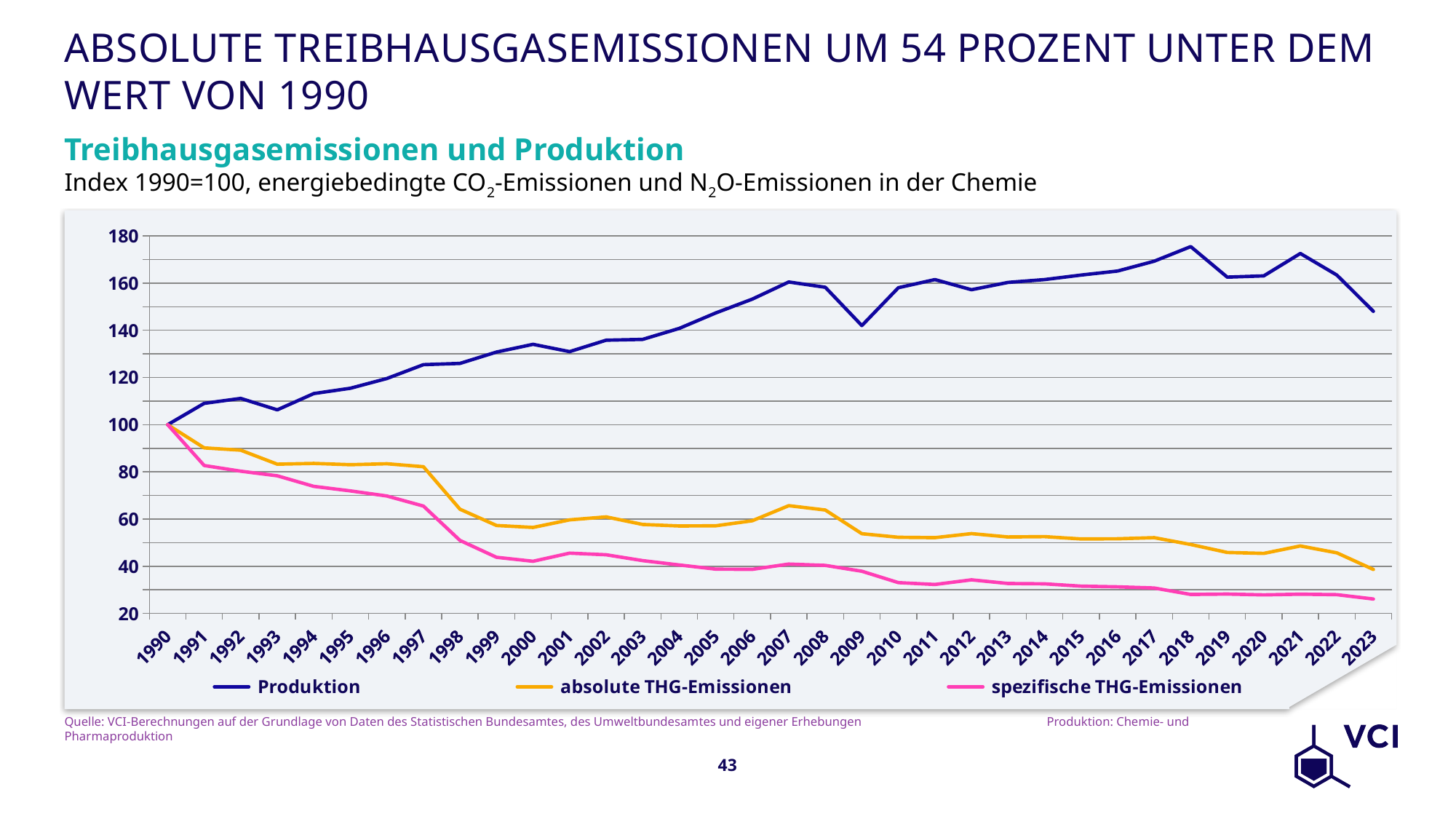
Is the value for absolute THG-Emissionen in 2007 greater or less than 60? greater Which series is drawn in orange? absolute THG-Emissionen How many years are plotted along the x axis? 34 Is the value for spezifische THG-Emissionen in 2023 greater or less than 40? less What is the index value of Produktion in 1990? 100 Is the value for Produktion in 2018 greater or less than 160? greater Does the spezifische THG-Emissionen line generally rise or fall from 1990 to 2023? fall In 2023, which is larger: Produktion or absolute THG-Emissionen? Produktion What kind of chart is shown on the slide? line chart How many series does the legend list? 3 In which year is the spezifische THG-Emissionen line at its lowest? 2023 In which year does the Produktion line reach its highest value? 2018